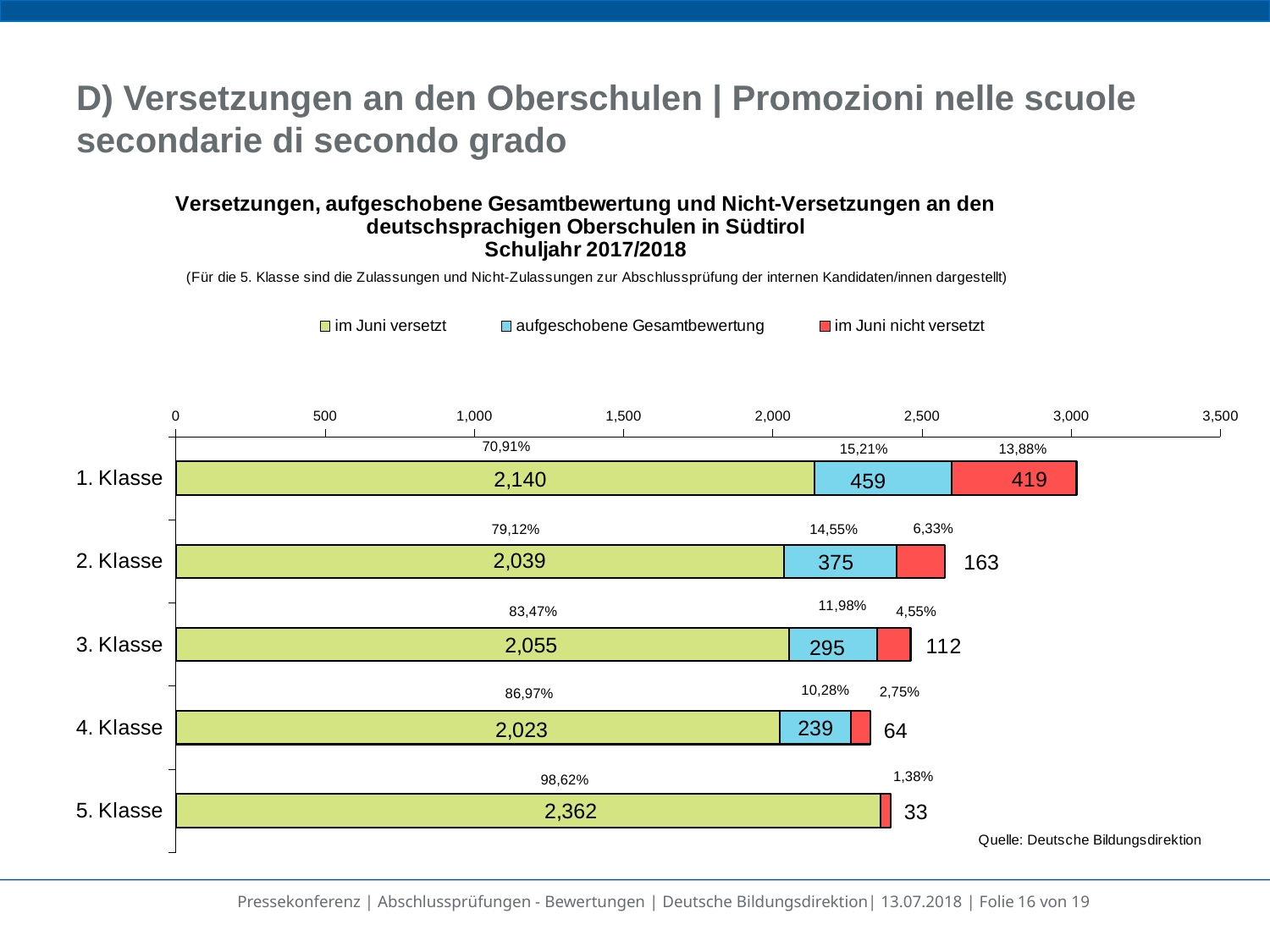
What is the value for 'im Juni versetzt' for 1. Klasse? 2,140 What is the difference between the 'im Juni versetzt' values for 5. Klasse and 4. Klasse? 339 What is the total of the stacked bar for 2. Klasse? 2,577 What is the value for 'aufgeschobene Gesamtbewertung' for 2. Klasse? 375 Which class has the lowest value for 'im Juni nicht versetzt'? 5. Klasse Which class has the highest value for 'im Juni nicht versetzt'? 1. Klasse Is the 'aufgeschobene Gesamtbewertung' value for 3. Klasse larger or smaller than that for 1. Klasse? smaller What percentage is shown for 'im Juni versetzt' for 5. Klasse? 98,62% What is the value for 'im Juni nicht versetzt' for 4. Klasse? 64 What kind of chart is shown on the slide? stacked bar chart How many classes (categories) are shown on the chart? 5 How many series does the legend list? 3